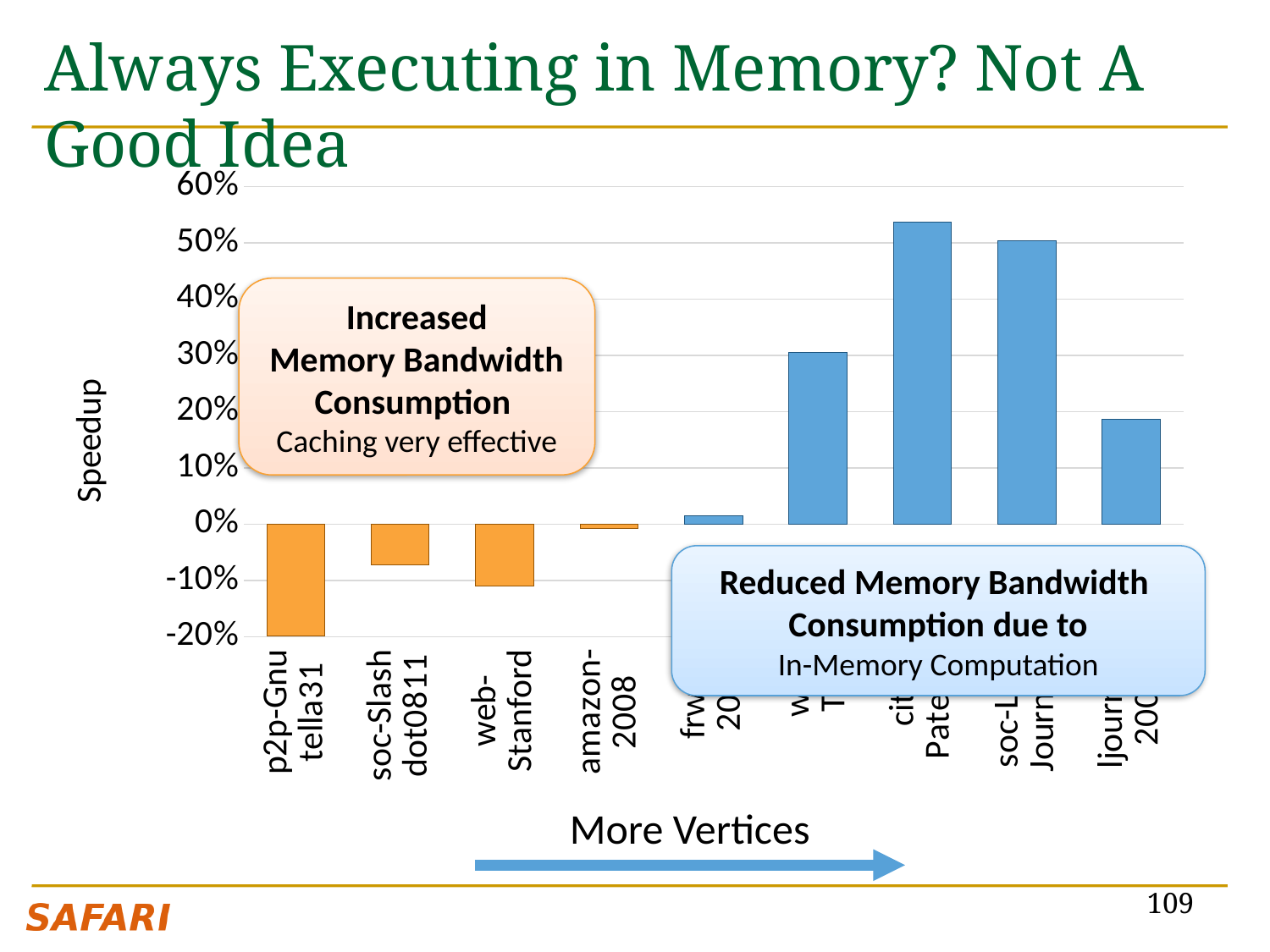
Which has the larger speedup, web-Stanford or soc-Slashdot0811? soc-Slashdot0811 Is the speedup for web-Stanford greater or less than 0%? less Is the speedup for amazon-2008 greater or less than -10%? greater How many categories (bars) are plotted in the chart? 9 Is the speedup for soc-Slashdot0811 greater or less than -10%? greater What is the label on the vertical axis of the chart? Speedup What colour are the bars with negative speedup values? orange Which category has the lowest speedup in the chart? p2p-Gnutella31 What kind of chart is shown on the slide? bar chart Do the speedup values generally rise or fall moving left to right along the x axis? rise Which has the larger speedup, p2p-Gnutella31 or amazon-2008? amazon-2008